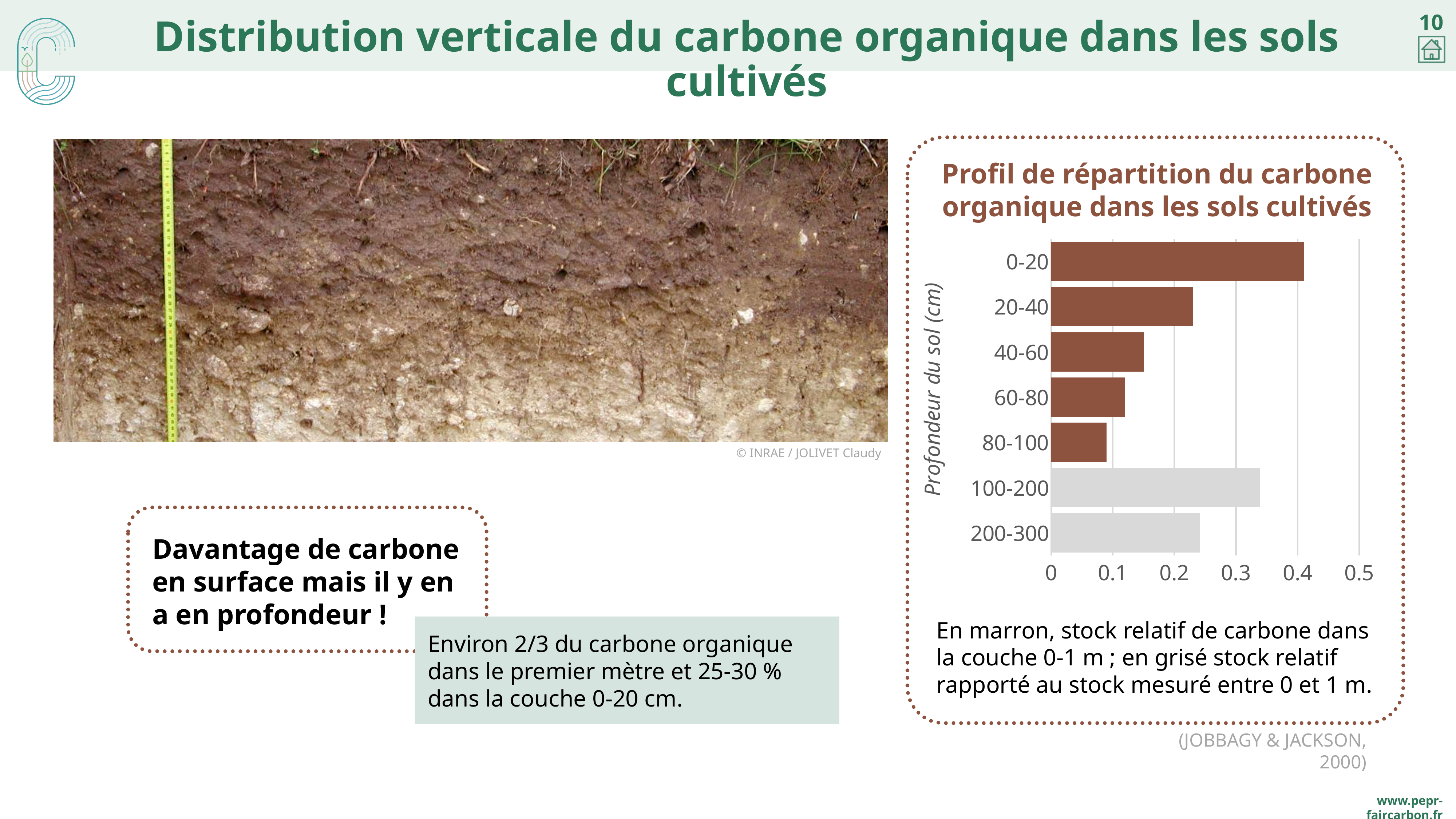
Which has the larger value, the 0-20 cm layer or the 100-200 cm layer? 0-20 Is the value for the 200-300 cm layer greater or less than 0.2? greater Which depth category has the lowest value in the chart? 80-100 What is the label of the vertical axis of the chart? Profondeur du sol (cm) Is the value for the 40-60 cm layer greater or less than 0.2? less Is the value for the 20-40 cm layer greater or less than 0.2? greater How many depth categories are plotted in the chart? 7 Do the brown bars increase or decrease as depth goes from 0-20 cm to 80-100 cm? decrease Which depth category has the highest value in the chart? 0-20 What kind of chart is shown on the slide? bar chart